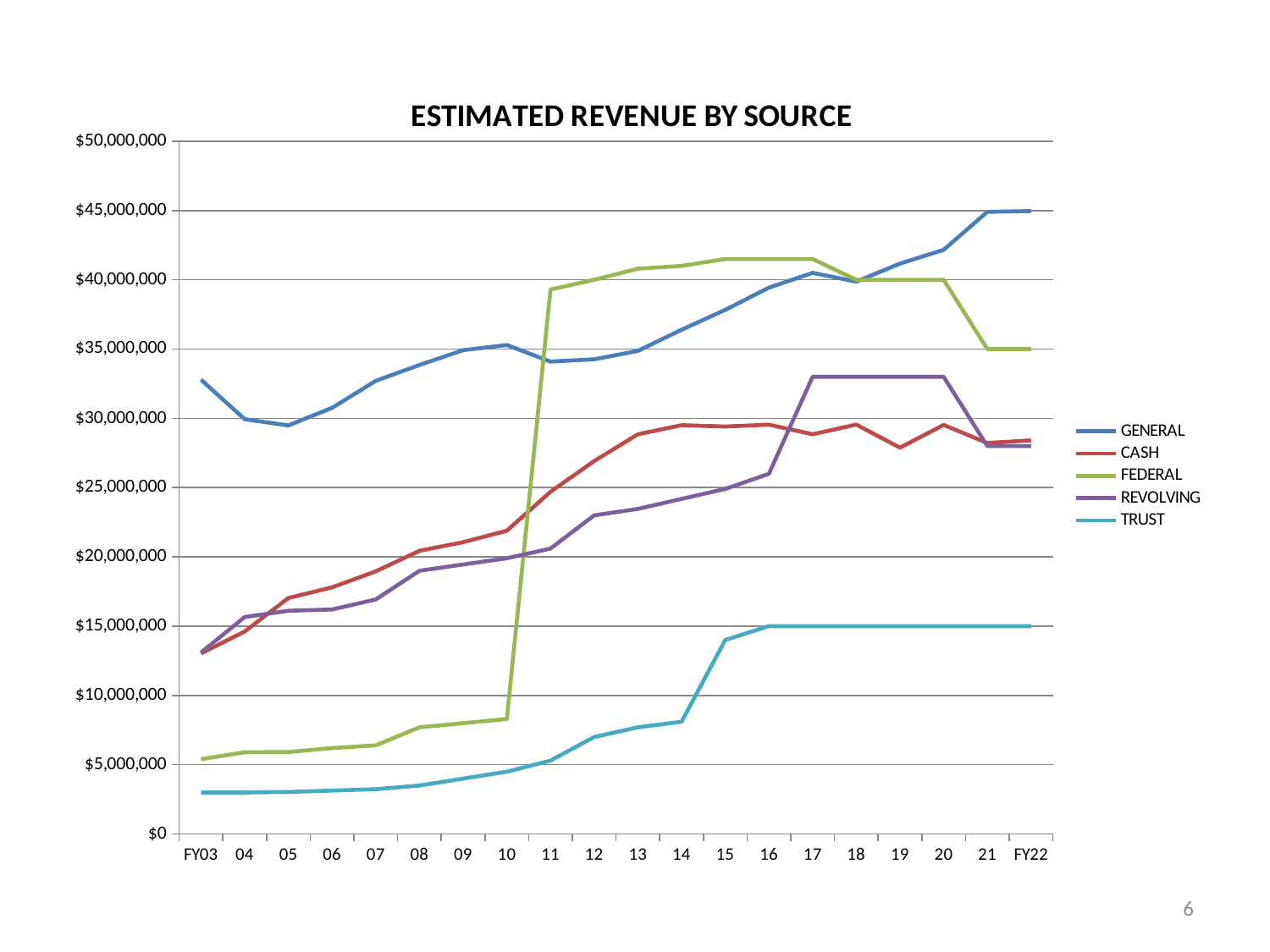
Which series has the lowest value in FY22? TRUST How many fiscal years are plotted along the x axis? 20 In FY17, which is larger, the value for REVOLVING or the value for CASH? REVOLVING What is the title of the chart? ESTIMATED REVENUE BY SOURCE How many series does the legend list? 5 Which series has the lowest value in FY03? TRUST What kind of chart is shown on the slide? line chart Which series has the highest value in FY22? GENERAL Does the TRUST series rise or fall from FY03 to FY16? rise Is the value for GENERAL in FY03 greater or less than $30,000,000? greater In FY12, which is larger, the value for FEDERAL or the value for GENERAL? FEDERAL Is the value for FEDERAL in FY10 greater or less than $10,000,000? less